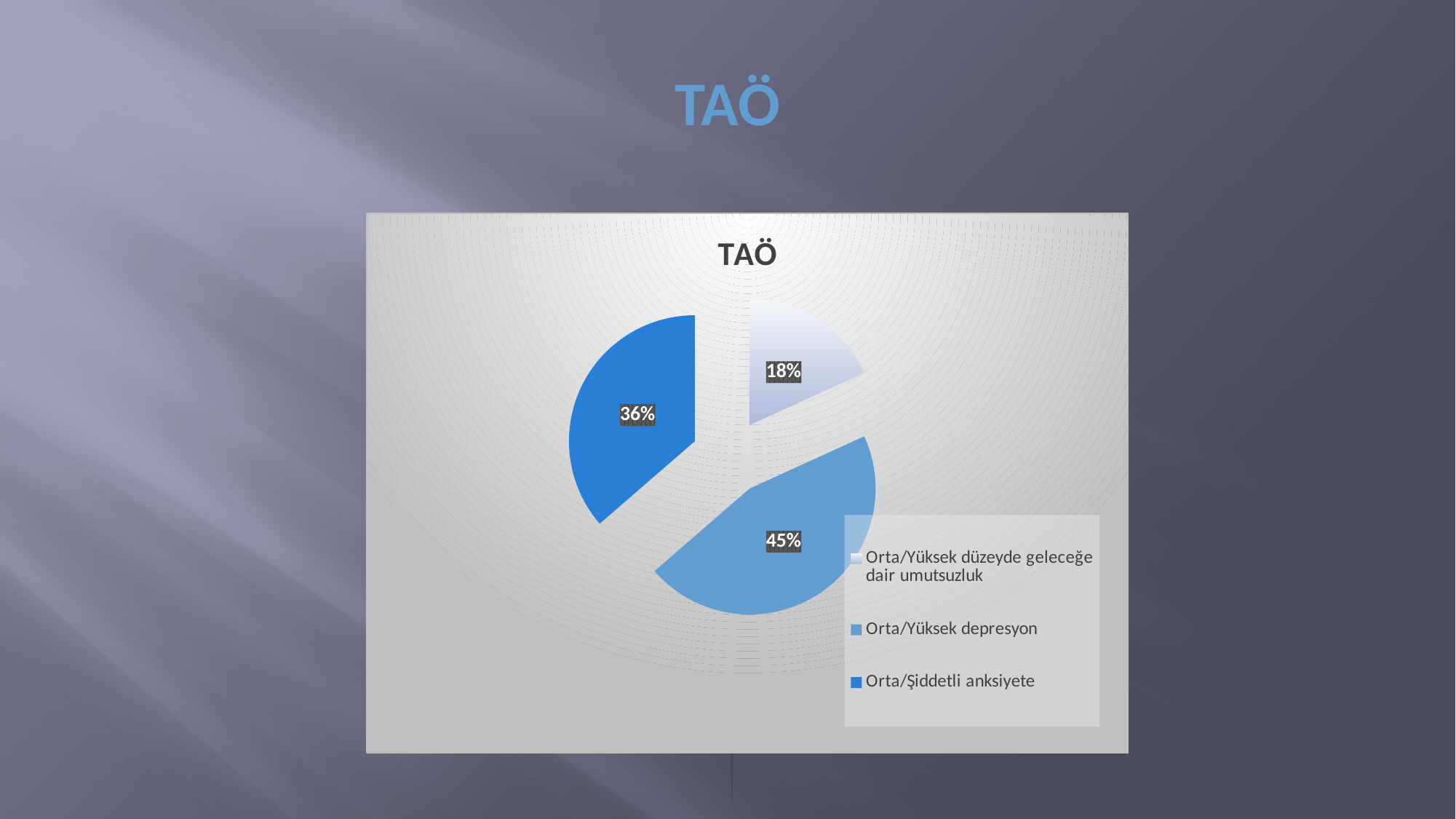
What kind of chart is shown on the slide? Pie chart What percentage is shown for Orta/Yüksek düzeyde geleceğe dair umutsuzluk? 18% How many slices does the pie chart have? 3 What percentage is shown for Orta/Şiddetli anksiyete? 36% How many entries does the legend list? 3 What is the difference in percentage points between Orta/Şiddetli anksiyete and Orta/Yüksek düzeyde geleceğe dair umutsuzluk? 18 Which category has the smallest slice of the pie? Orta/Yüksek düzeyde geleceğe dair umutsuzluk What is the title of the chart? TAÖ What percentage is shown for Orta/Yüksek depresyon? 45% Which is larger, the slice for Orta/Şiddetli anksiyete or the slice for Orta/Yüksek düzeyde geleceğe dair umutsuzluk? Orta/Şiddetli anksiyete Which category has the largest slice of the pie? Orta/Yüksek depresyon What is the difference in percentage points between Orta/Yüksek depresyon and Orta/Şiddetli anksiyete? 9